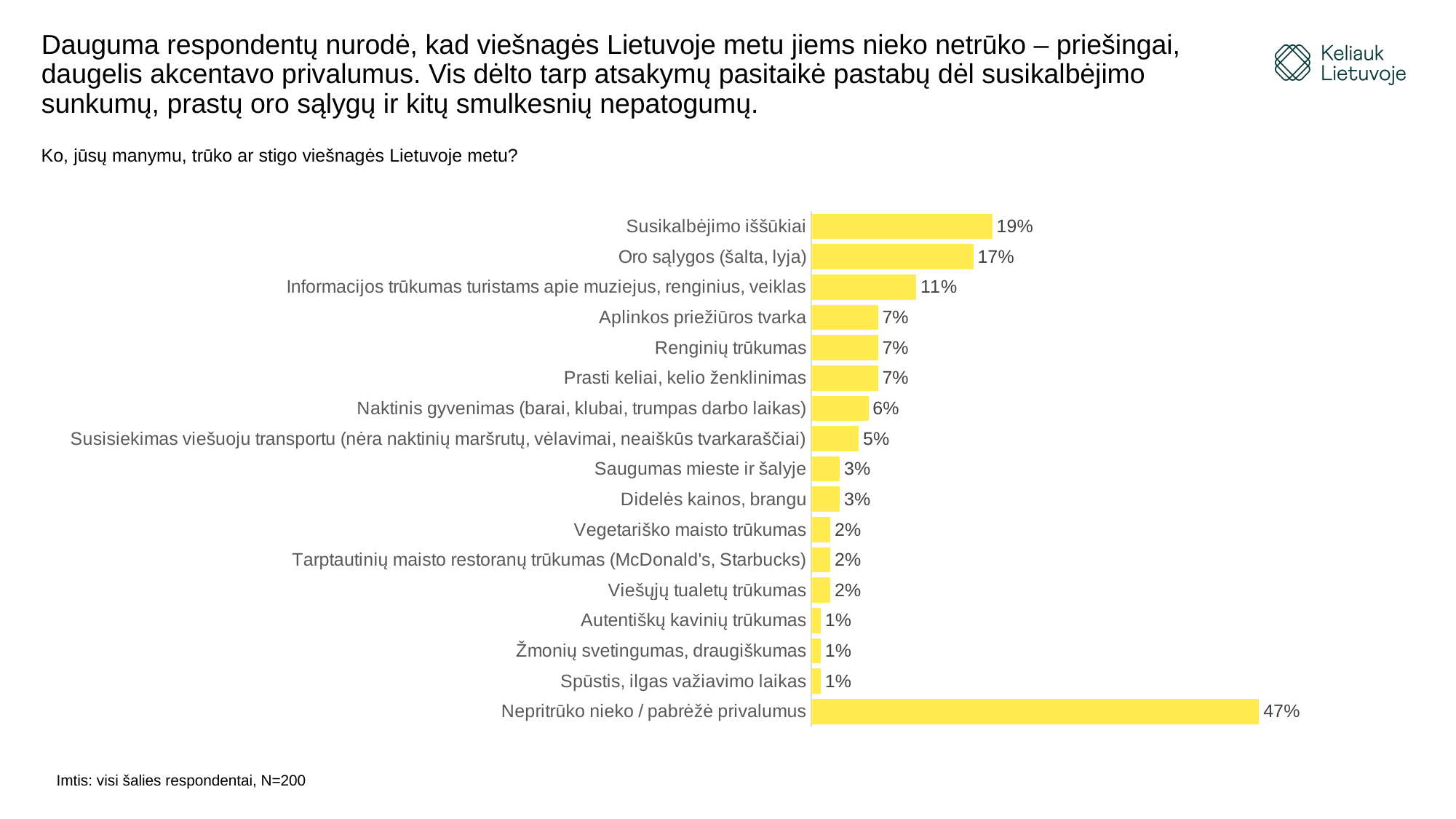
Which is larger: "Saugumas mieste ir šalyje" or "Susisiekimas viešuoju transportu (nėra naktinių maršrutų, vėlavimai, neaiškūs tvarkaraščiai)"? Susisiekimas viešuoju transportu (nėra naktinių maršrutų, vėlavimai, neaiškūs tvarkaraščiai) Which category has the highest value in the chart? Nepritrūko nieko / pabrėžė privalumus What is the difference between "Susikalbėjimo iššūkiai" and "Oro sąlygos (šalta, lyja)"? 2% What is the value for "Nepritrūko nieko / pabrėžė privalumus"? 47% What is the value for "Oro sąlygos (šalta, lyja)"? 17% How many categories are shown in the chart? 17 What is the difference between "Nepritrūko nieko / pabrėžė privalumus" and "Susikalbėjimo iššūkiai"? 28% What is the value for "Naktinis gyvenimas (barai, klubai, trumpas darbo laikas)"? 6% What percentage of respondents mentioned "Susikalbėjimo iššūkiai"? 19% What is the sample size stated below the chart? N=200 What kind of chart is shown on the slide? Bar chart Which is larger: "Informacijos trūkumas turistams apie muziejus, renginius, veiklas" or "Aplinkos priežiūros tvarka"? Informacijos trūkumas turistams apie muziejus, renginius, veiklas